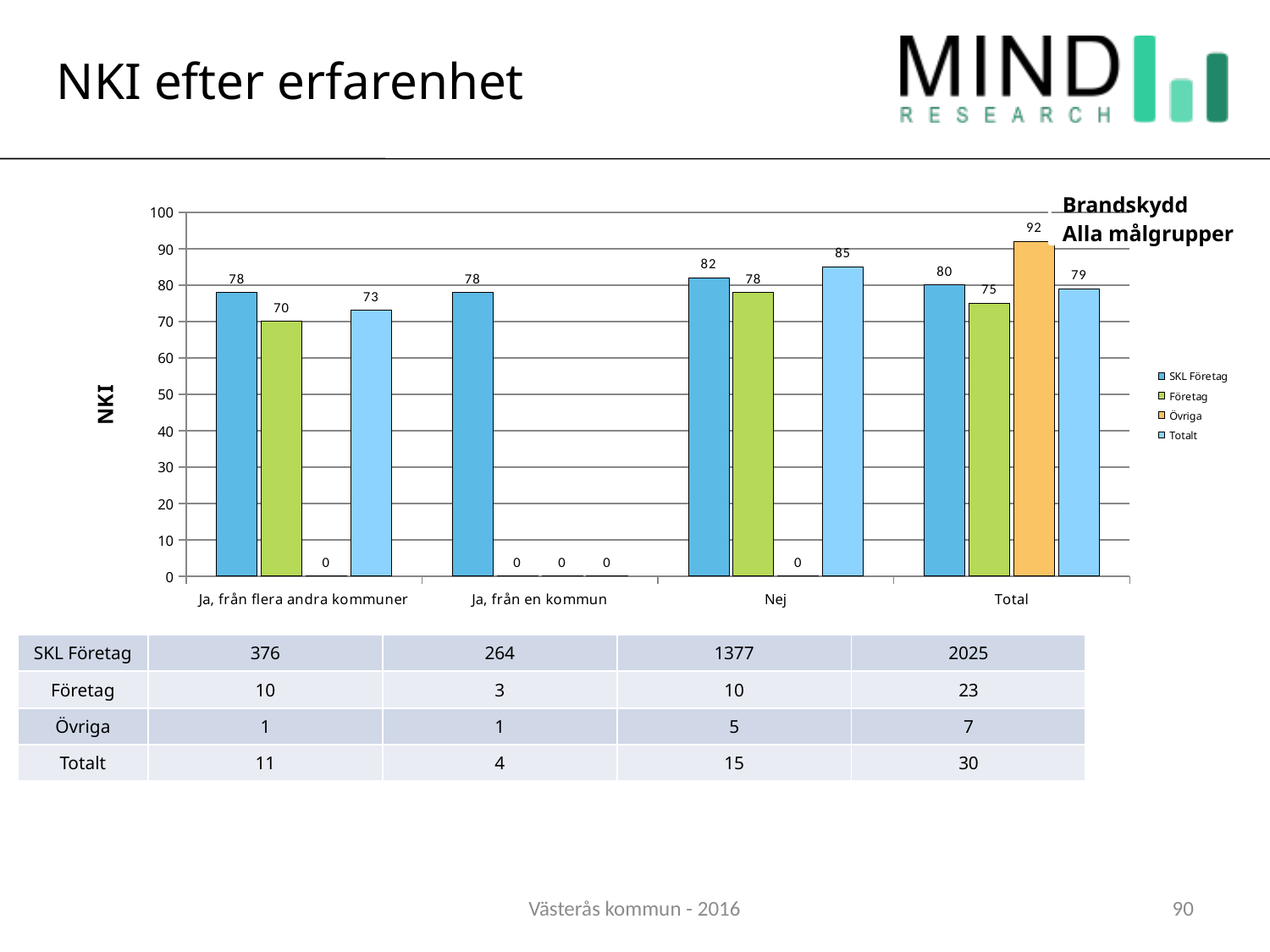
What type of chart is shown on the slide? Bar chart How many series does the chart legend list? 4 What is the NKI value for Övriga in the 'Total' category? 92 How many categories are shown on the x axis of the chart? 4 What is the difference between the Totalt value for 'Nej' and the Totalt value for 'Total'? 6 What is the NKI value for Företag in the 'Total' category? 75 What is the NKI value for Totalt in the 'Ja, från flera andra kommuner' category? 73 Which series has the lowest non-zero NKI value in the 'Ja, från flera andra kommuner' category? Företag What is the label of the y axis of the chart? NKI Which series has the highest NKI value in the 'Total' category? Övriga Which is larger: the SKL Företag value for 'Nej' or the SKL Företag value for 'Total'? Nej What is the NKI value for SKL Företag in the 'Nej' category? 82